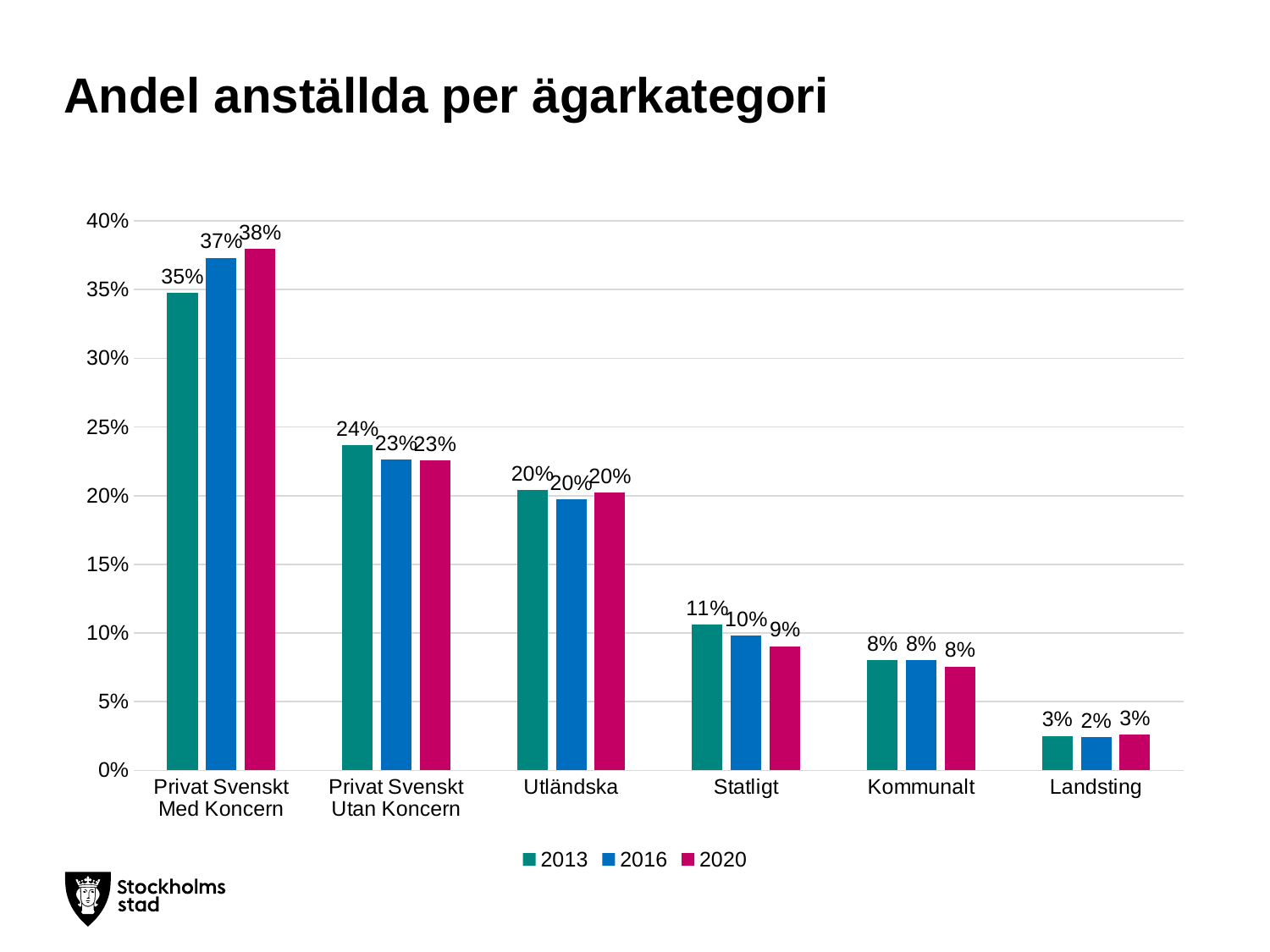
Which is larger: the 2013 value for Statligt or the 2013 value for Kommunalt? Statligt How many series does the legend list? 3 Which category has the highest value in 2016? Privat Svenskt Med Koncern What is the value for Privat Svenskt Utan Koncern in 2013? 24% What is the difference between the 2020 and 2013 values for Privat Svenskt Med Koncern? 3% What is the value for Landsting in 2016? 2% What kind of chart is shown on the slide? Bar chart Which category has the lowest value in 2013? Landsting What is the value for Statligt in 2013? 11% What is the title of the chart? Andel anställda per ägarkategori What is the value for Privat Svenskt Med Koncern in 2020? 38% How many categories are shown on the x axis? 6